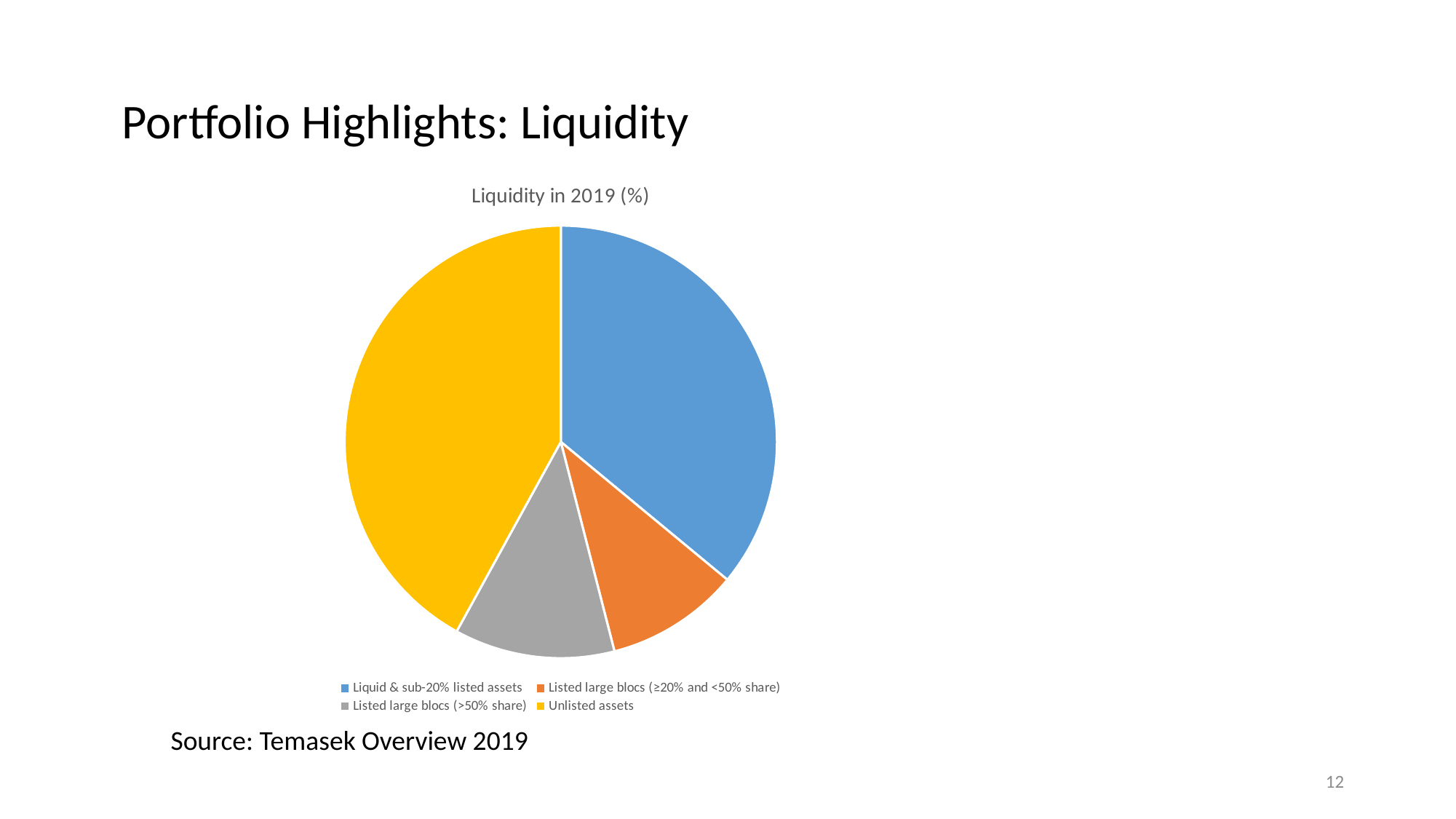
Which slice is larger: Unlisted assets or Liquid & sub-20% listed assets? Unlisted assets What is the title of the chart? Liquidity in 2019 (%) Which slice is larger: Unlisted assets or Listed large blocs (>50% share)? Unlisted assets Which category has the largest slice of the pie? Unlisted assets Which colour represents Unlisted assets in the pie chart? yellow How many slices does the pie chart have? 4 How many entries does the legend list? 4 What kind of chart is shown on the slide? pie chart Which category is shown in blue? Liquid & sub-20% listed assets Which slice is larger: Liquid & sub-20% listed assets or Listed large blocs (≥20% and <50% share)? Liquid & sub-20% listed assets